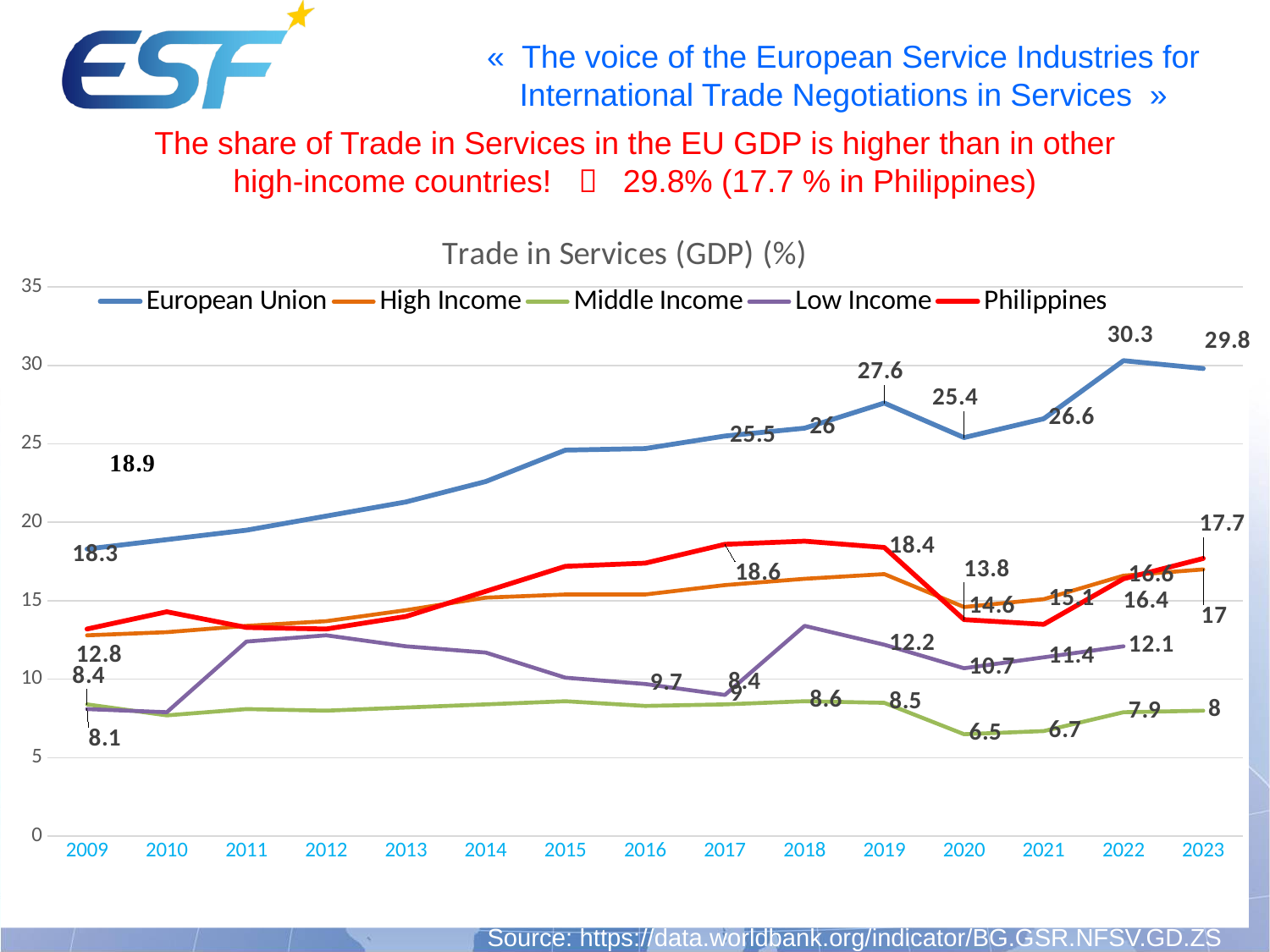
What is the title of the chart? Trade in Services (GDP) (%) What is the value for the European Union in 2022? 30.3 What is the value for the European Union in 2023? 29.8 What is the value for Middle Income in 2020? 6.5 How many series does the chart legend list? 5 Which series has the highest value in 2023? European Union What is the value for Low Income in 2022? 12.1 What is the difference between the European Union and the Philippines values in 2023? 12.1 What is the value for the Philippines in 2023? 17.7 Is the value for Low Income in 2011 greater or less than 10? greater How many years are shown on the x axis of the chart? 15 What type of chart is shown on the slide? line chart